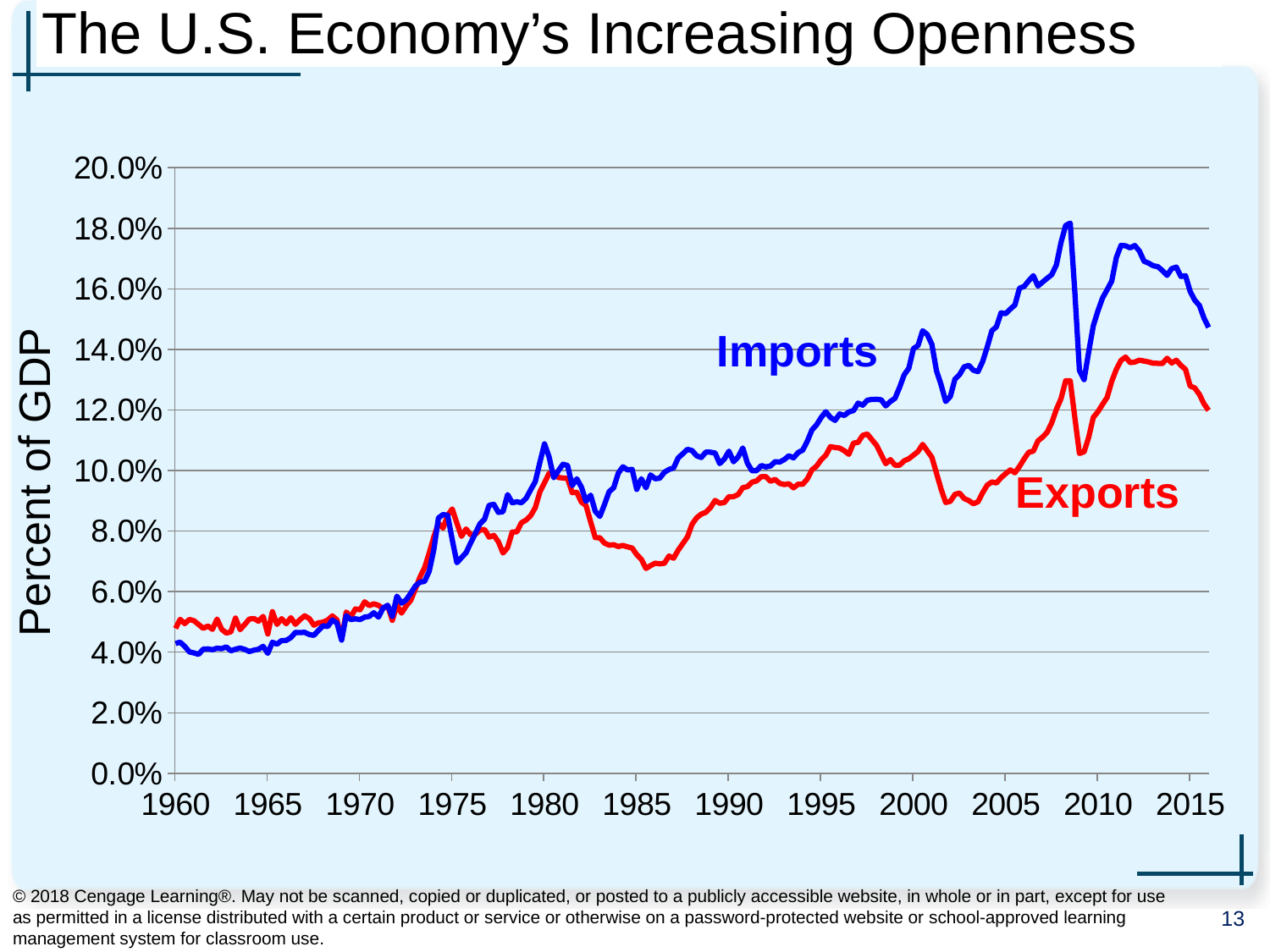
Which series reaches the higher peak value over the period shown, Imports or Exports? Imports Is the value for Exports in 2012 greater or less than 12.0%? greater What are the names of the two series plotted on the chart? Imports and Exports Do the Imports values generally rise or fall from 1960 to 2015? rise What is the label on the vertical axis of the chart? Percent of GDP Is the value for Imports in 2005 greater or less than 14.0%? greater What kind of chart is shown on the slide? line chart How many series are plotted on the chart? 2 In 2015, which series has the larger value, Imports or Exports? Imports Is the value for Exports in 1985 greater or less than 8.0%? less In 1960, which series has the larger value, Imports or Exports? Exports